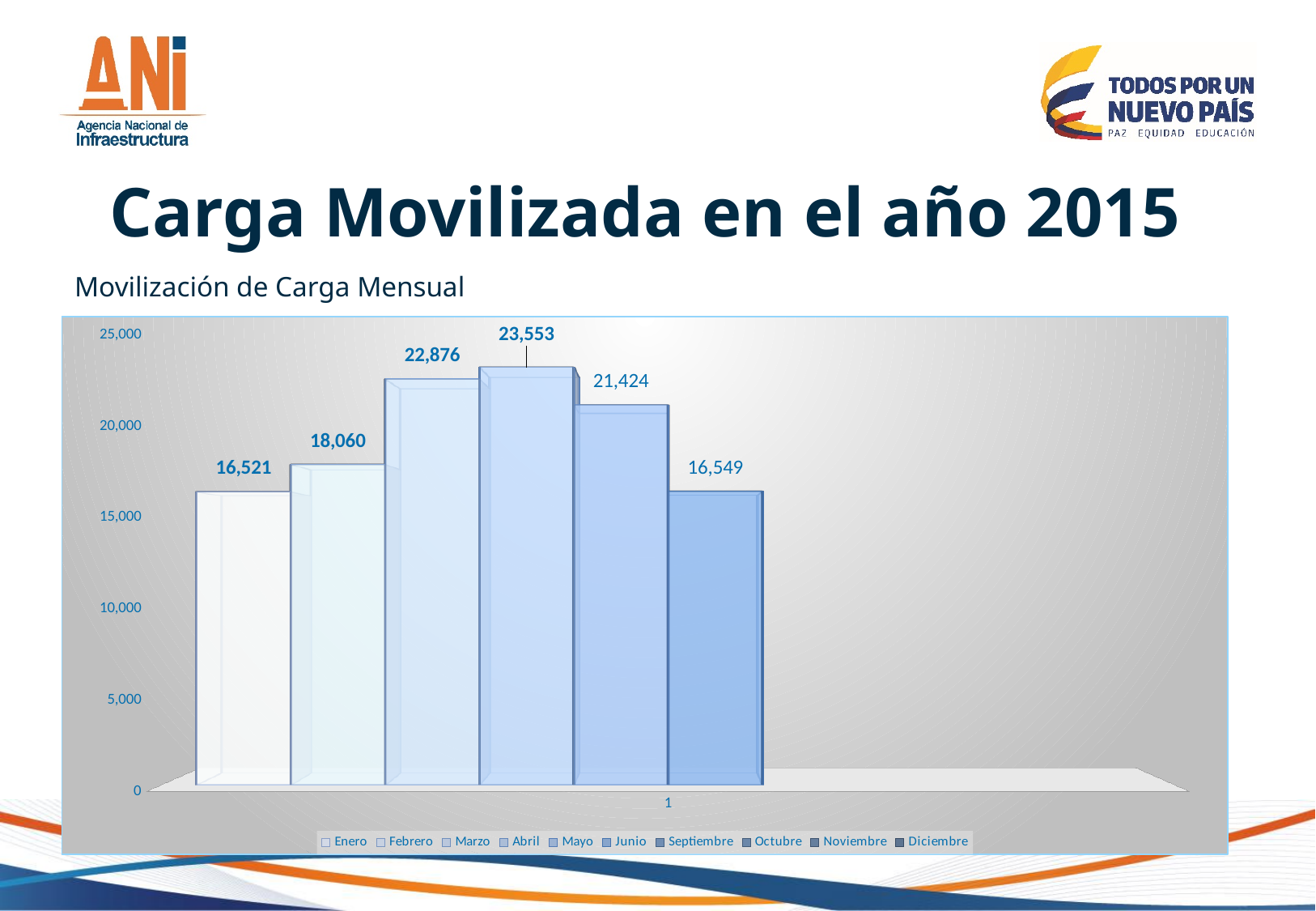
What is the difference between the bar labelled 21,424 and the bar labelled 16,549? 4,875 What is the subtitle shown above the chart? Movilización de Carga Mensual What is the value shown on the tallest bar? 23,553 Which is larger, the first bar (16,521) or the last bar (16,549)? 16,549 What type of chart is shown on the slide? bar chart What is the value of the last (rightmost) bar? 16,549 How many series does the legend list? 10 Is the value of the fourth bar greater or less than 20,000? greater What is the value of the first (leftmost) bar? 16,521 What is the difference between the tallest bar (23,553) and the bar labelled 22,876? 677 How many bars are plotted in the chart? 6 What is the value shown on the shortest bar? 16,521